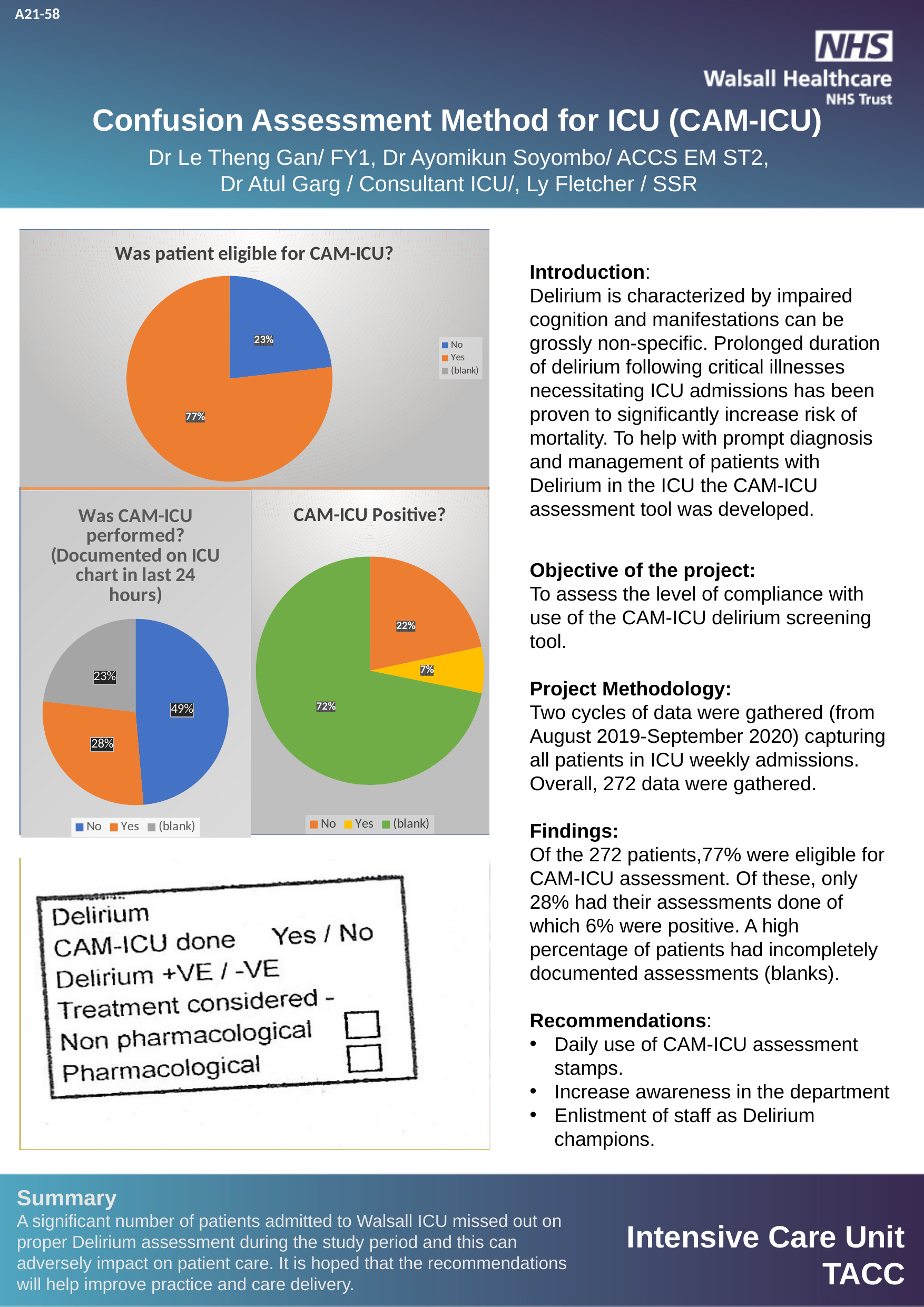
In the 'Was CAM-ICU performed?' chart, which category has the smallest share? (blank) In the 'Was patient eligible for CAM-ICU?' chart, what share of patients were eligible (Yes)? 77% In the 'CAM-ICU Positive?' chart, what is the difference between the No and Yes shares? 15% In the 'CAM-ICU Positive?' chart, what percentage is shown for Yes? 7% What kind of chart is 'Was patient eligible for CAM-ICU?' Pie chart In the 'Was CAM-ICU performed?' chart, what percentage is shown for Yes? 28% In the 'Was CAM-ICU performed?' chart, which category has the largest share? No In the 'Was CAM-ICU performed?' chart, how many categories does the legend list? 3 In the 'CAM-ICU Positive?' chart, what colour represents the Yes slice? Yellow In the 'Was patient eligible for CAM-ICU?' chart, what is the difference between the Yes and No shares? 54% In the 'CAM-ICU Positive?' chart, which category has the largest share? (blank) In the 'Was patient eligible for CAM-ICU?' chart, what percentage is shown for No? 23%